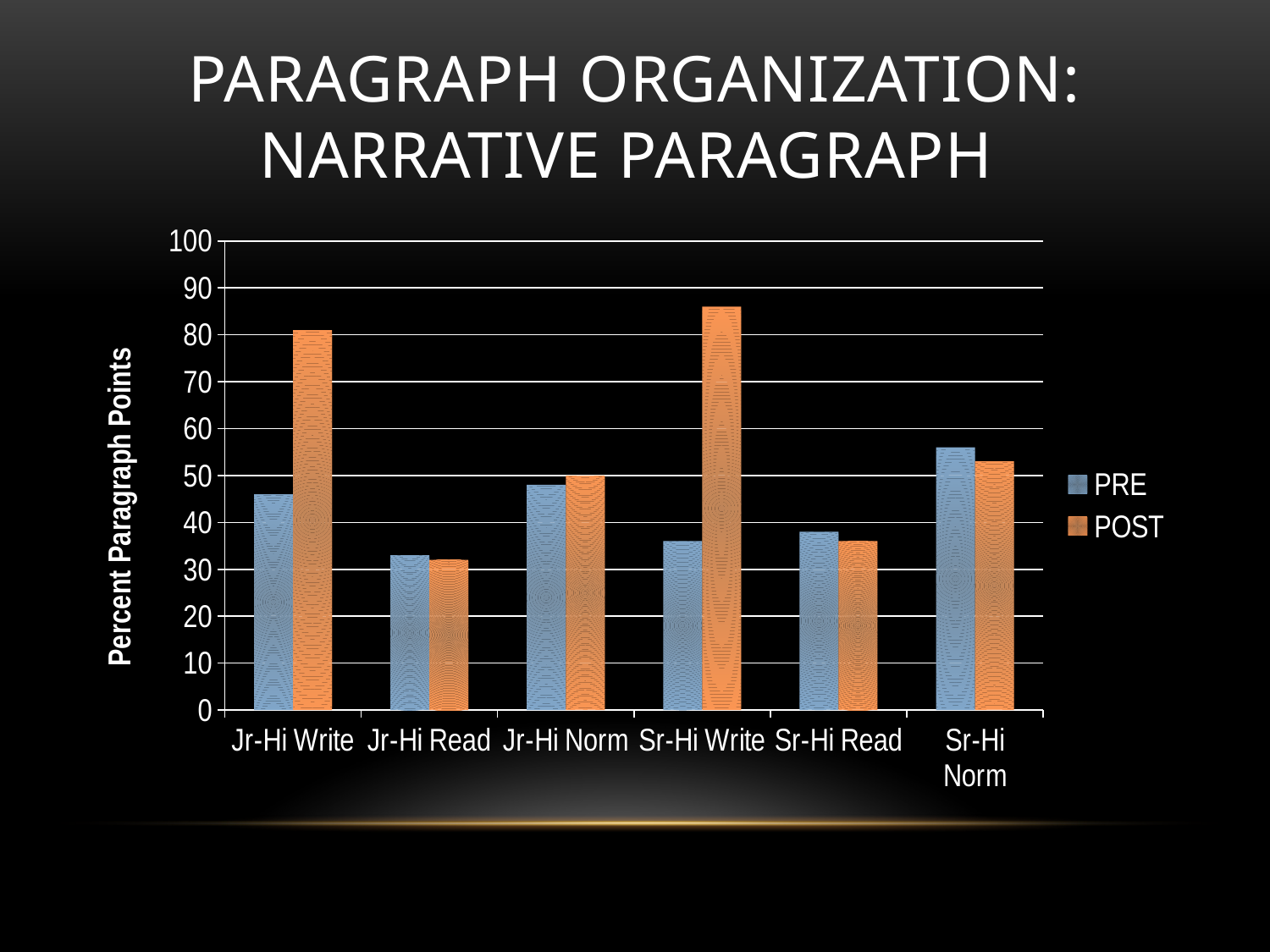
Which category has the highest PRE value? Sr-Hi Norm Is the PRE value for Sr-Hi Write greater or less than 40? less What is the label of the vertical axis? Percent Paragraph Points Which category has the highest POST value? Sr-Hi Write Which is larger, the PRE value for Sr-Hi Norm or the PRE value for Jr-Hi Read? Sr-Hi Norm For Sr-Hi Write, which is larger, the PRE value or the POST value? POST How many series does the legend list? 2 What kind of chart is shown on the slide? bar chart Which category has the lowest PRE value? Jr-Hi Read How many categories are shown on the x axis? 6 Which category has the lowest POST value? Jr-Hi Read